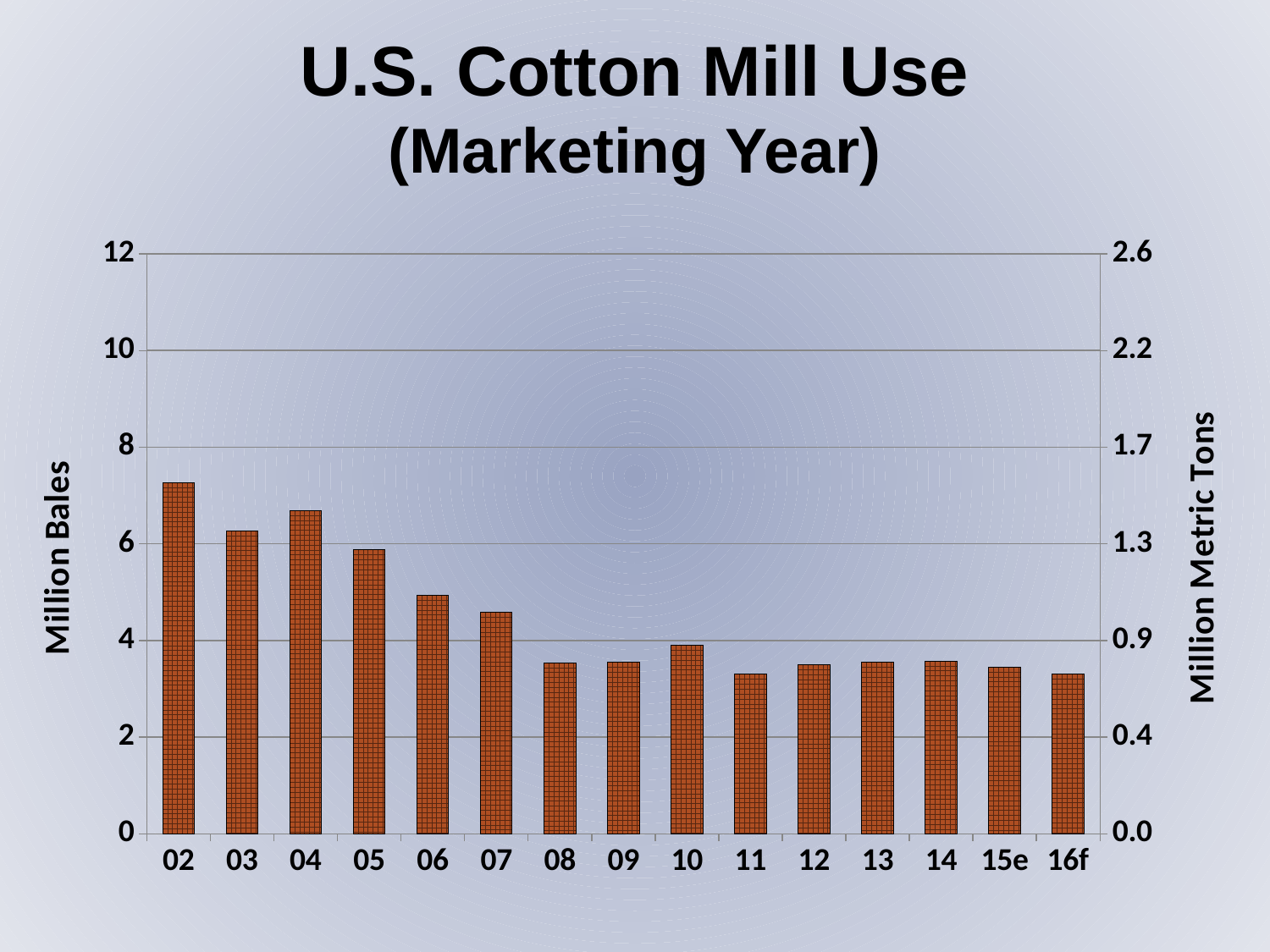
Which marketing year has the highest cotton mill use? 02 Is the value for 06 greater or less than 4 million bales? greater Is the value for 08 greater or less than 4 million bales? less Which is larger, the value for 04 or the value for 05? 04 What kind of chart is shown on the slide? bar chart Which is larger, the value for 02 or the value for 03? 02 What is the label on the left vertical axis? Million Bales How many marketing years are plotted on the chart? 15 Is the value for 11 greater or less than 4 million bales? less Overall, do the values rise or fall from 02 to 16f? fall